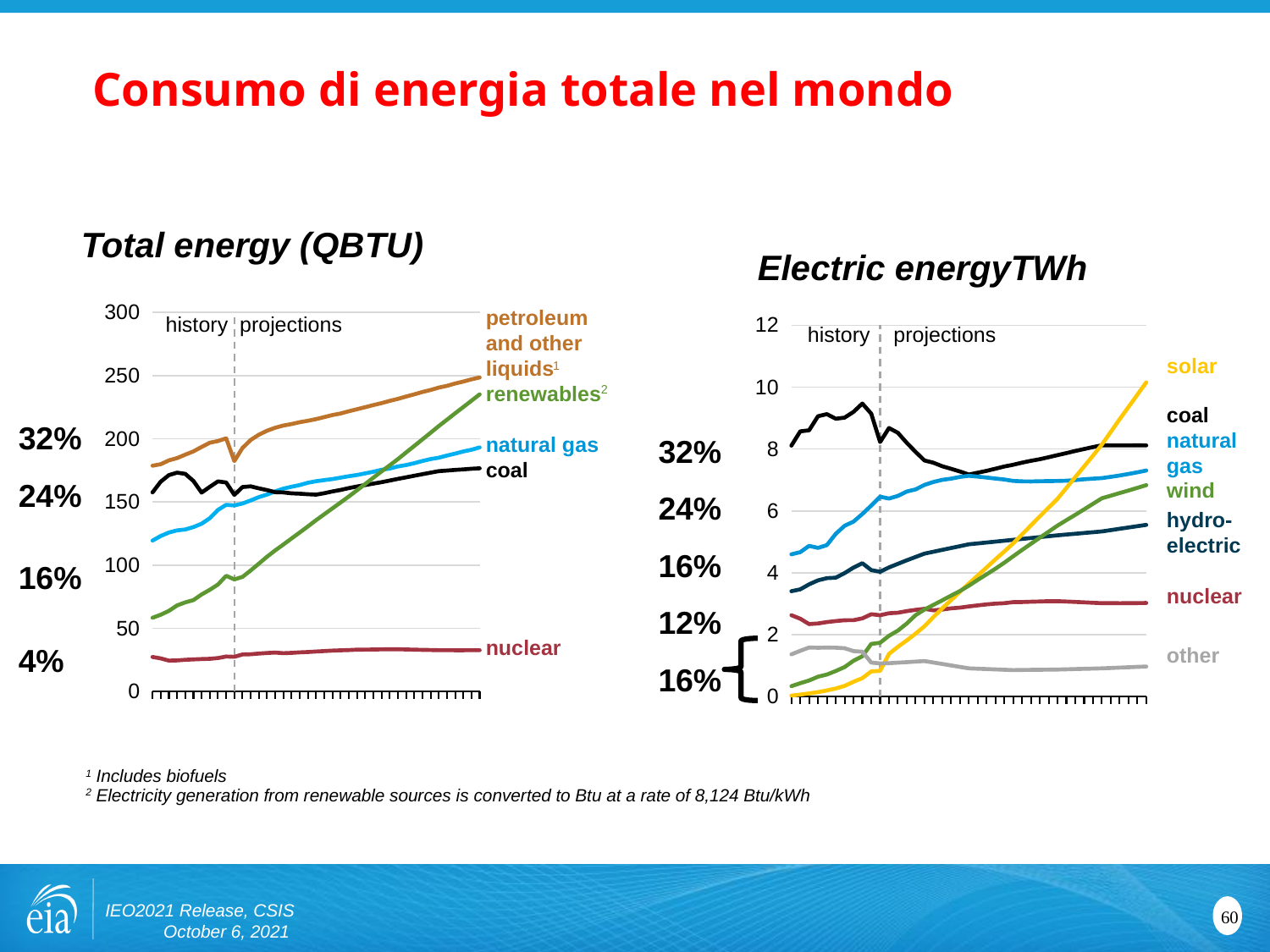
In the "Total energy (QBTU)" chart, which series has the lowest value throughout the period? nuclear In the "Electric energy TWh" chart, does the solar series rise or fall over the projection period? rise In the "Electric energy TWh" chart, is the value for hydroelectric at the end of the projections greater or less than 6? less In the "Electric energy TWh" chart, which series has the lowest value at the end of the projection period? other In the "Total energy (QBTU)" chart, is the value for nuclear at the end of the projections greater or less than 50? less What type of chart is the "Total energy (QBTU)" chart on the left? line chart How many series are labelled on the "Total energy (QBTU)" chart on the left? 5 How many series are labelled on the "Electric energy TWh" chart on the right? 7 In the "Total energy (QBTU)" chart, which series has the highest value at the end of the projection period? petroleum and other liquids In the "Electric energy TWh" chart, which series has the highest value at the end of the projection period? solar In the "Electric energy TWh" chart, which is larger at the end of the projections, wind or hydroelectric? wind In the "Total energy (QBTU)" chart, is the value for renewables at the end of the projections greater or less than 200? greater